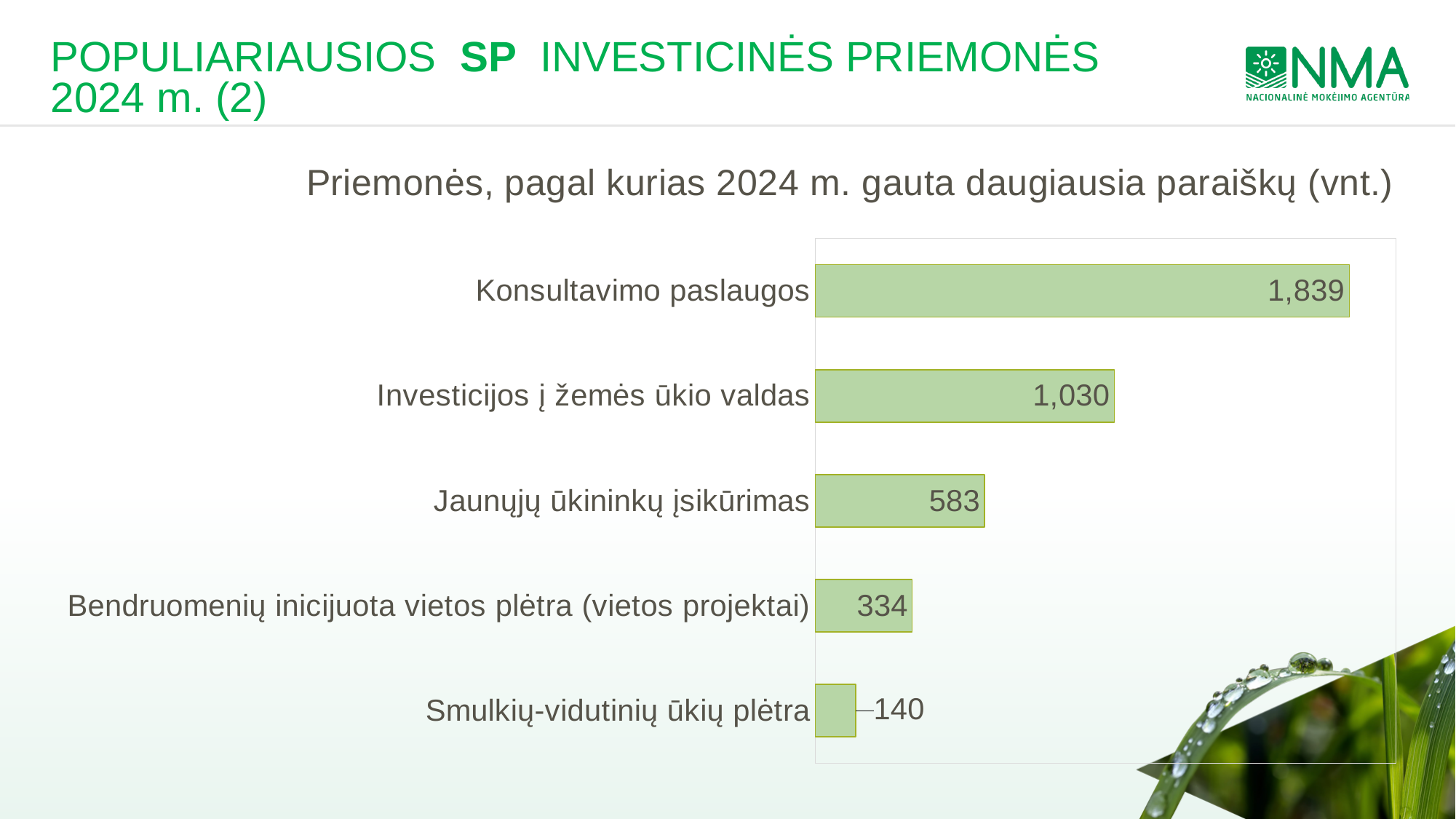
What is the value for Smulkių-vidutinių ūkių plėtra? 140 What is the value for Bendruomenių inicijuota vietos plėtra (vietos projektai)? 334 What is the value for Jaunųjų ūkininkų įsikūrimas? 583 How many categories are shown in the chart? 5 Which category has the highest value? Konsultavimo paslaugos What is the title of the chart? Priemonės, pagal kurias 2024 m. gauta daugiausia paraiškų (vnt.) What kind of chart is shown on the slide? Bar chart What is the value for Investicijos į žemės ūkio valdas? 1,030 What is the value for Konsultavimo paslaugos? 1,839 Which category has the lowest value? Smulkių-vidutinių ūkių plėtra Which is larger, the value for Jaunųjų ūkininkų įsikūrimas or the value for Bendruomenių inicijuota vietos plėtra (vietos projektai)? Jaunųjų ūkininkų įsikūrimas What is the difference between the values for Konsultavimo paslaugos and Investicijos į žemės ūkio valdas? 809